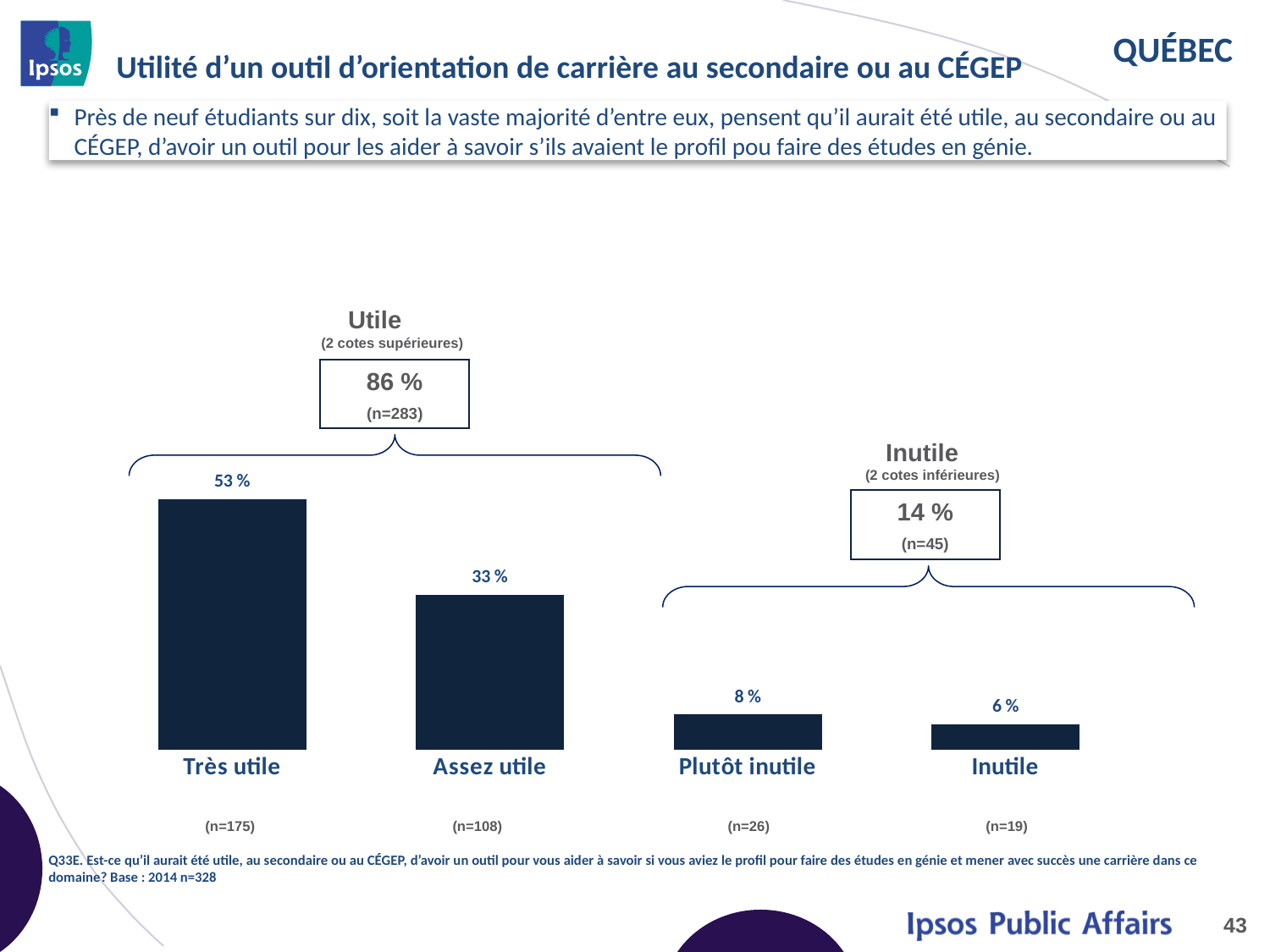
How many categories are shown in the chart? 4 What is the value for "Inutile"? 6 % What is the difference between the values for "Très utile" and "Assez utile"? 20 % What is the value for "Assez utile"? 33 % Which category has the lowest value? Inutile What is the combined value shown for "Utile (2 cotes supérieures)"? 86 % What is the value for "Plutôt inutile"? 8 % Which is larger, the value for "Plutôt inutile" or the value for "Inutile"? Plutôt inutile What is the sample size (n) shown for "Très utile"? n=175 What is the value for "Très utile"? 53 % What kind of chart is shown on the slide? Bar chart Which category has the highest value? Très utile